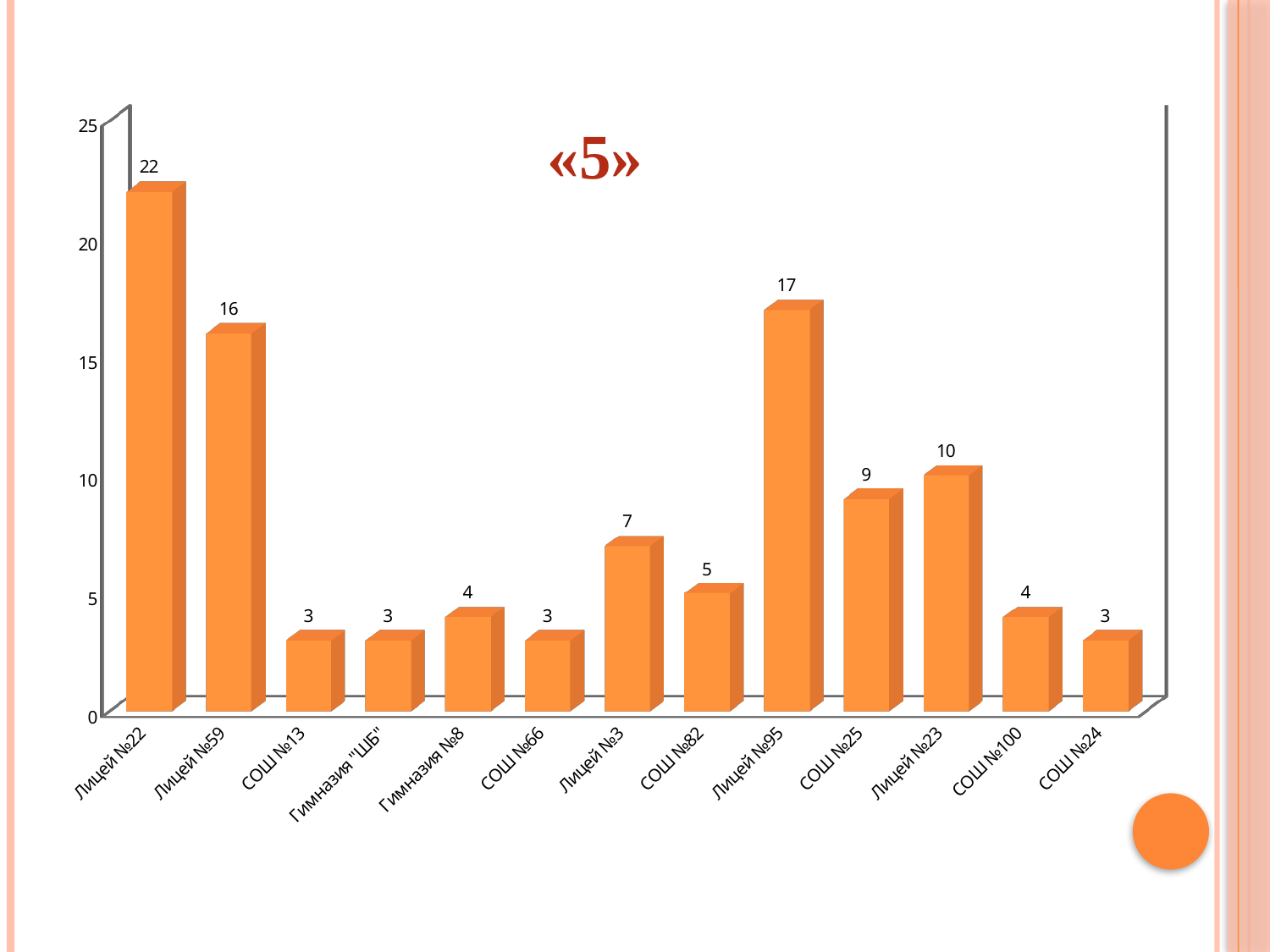
What is the value for СОШ №25? 9 What is the title of the chart? «5» What is the value for Лицей №95? 17 What kind of chart is shown on the slide? bar chart Which category has the highest value? Лицей №22 What is the difference between the values for Лицей №22 and Лицей №59? 6 Is the value for Лицей №59 greater or less than 15? greater What is the value for Лицей №22? 22 What is the difference between the values for Лицей №23 and СОШ №82? 5 What is the value for Гимназия №8? 4 Which is larger, the value for Лицей №3 or the value for СОШ №100? Лицей №3 How many categories are shown on the x axis? 13